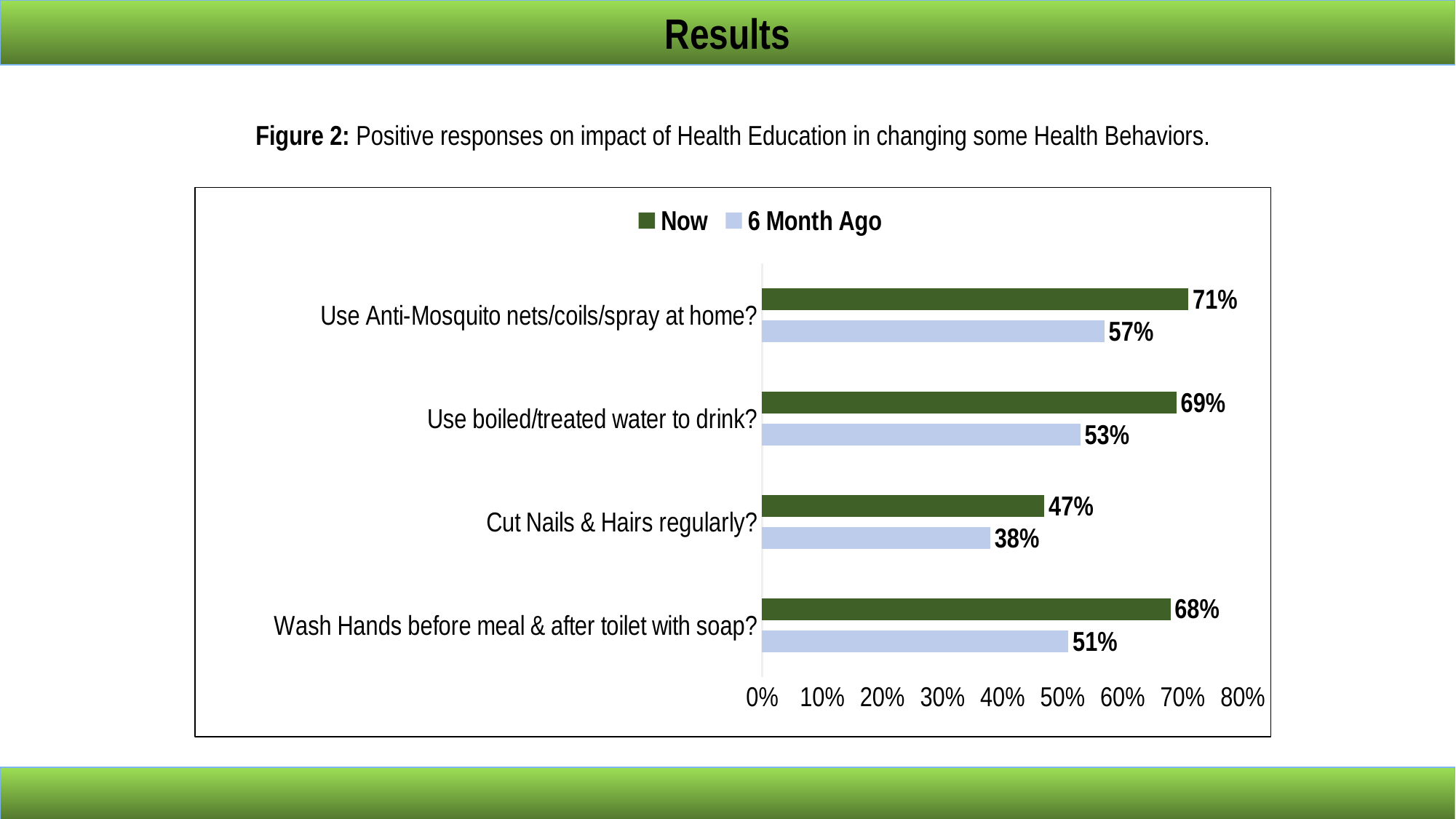
Which is larger: the 'Now' value for 'Cut Nails & Hairs regularly?' or the '6 Month Ago' value for 'Use boiled/treated water to drink?'? 6 Month Ago value for Use boiled/treated water to drink? How many categories are shown in the chart? 4 What is the difference between the 'Now' and '6 Month Ago' values for 'Wash Hands before meal & after toilet with soap?'? 17% Which category has the highest 'Now' value? Use Anti-Mosquito nets/coils/spray at home? Which series is shown in dark green in the legend? Now What is the '6 Month Ago' value for 'Wash Hands before meal & after toilet with soap?'? 51% What is the difference between the 'Now' and '6 Month Ago' values for 'Use boiled/treated water to drink?'? 16% How many series does the legend list? 2 What kind of chart is shown on the slide? Bar chart What is the 'Now' value for 'Use Anti-Mosquito nets/coils/spray at home?'? 71% What is the '6 Month Ago' value for 'Cut Nails & Hairs regularly?'? 38% Which category has the lowest '6 Month Ago' value? Cut Nails & Hairs regularly?